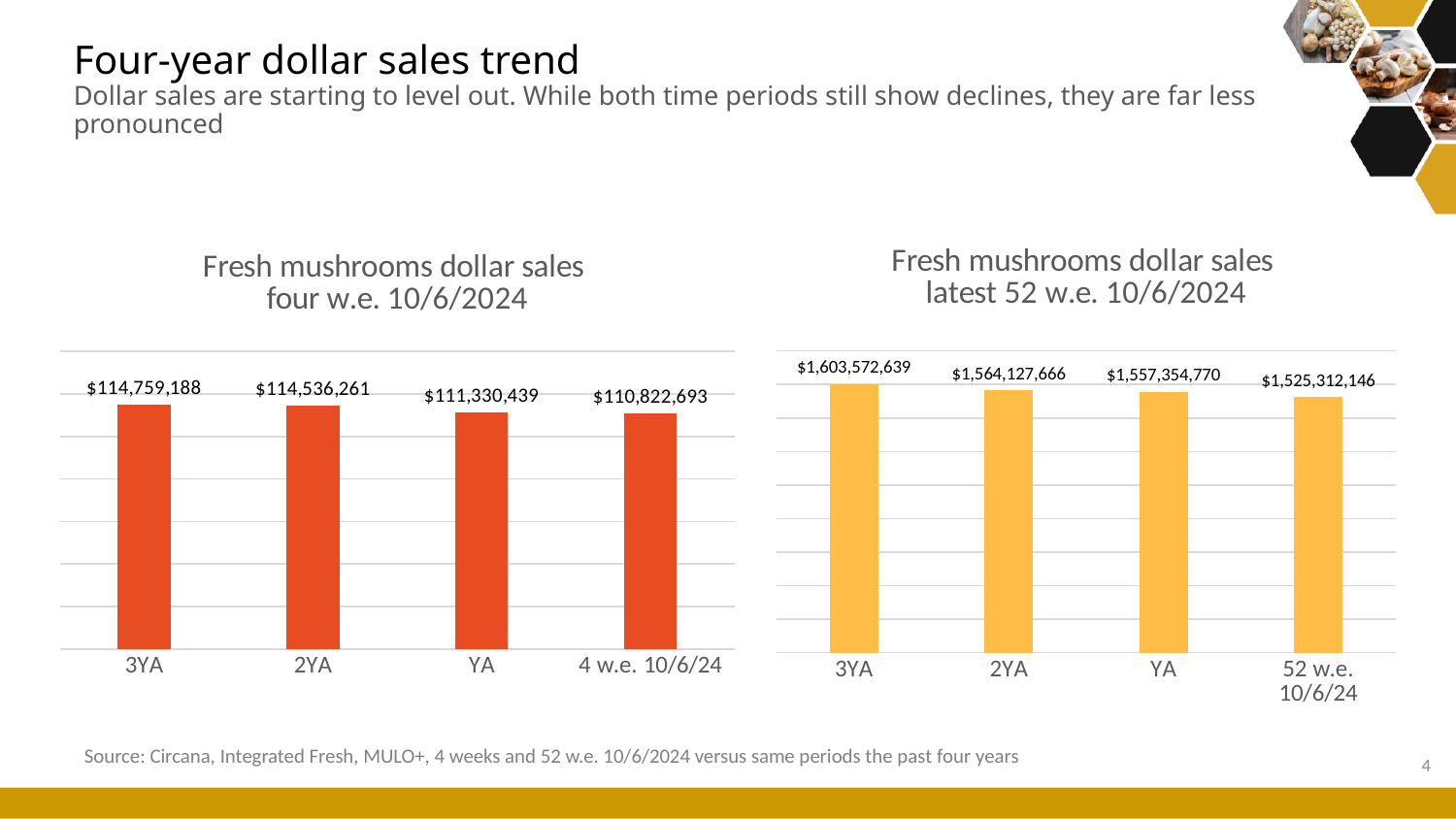
In the 'Fresh mushrooms dollar sales latest 52 w.e. 10/6/2024' chart, what is the difference between the 3YA value and the 52 w.e. 10/6/24 value? $78,260,493 How many categories are shown in the 'Fresh mushrooms dollar sales latest 52 w.e. 10/6/2024' chart? 4 In the 'Fresh mushrooms dollar sales latest 52 w.e. 10/6/2024' chart, what is the value for 52 w.e. 10/6/24? $1,525,312,146 In the 'Fresh mushrooms dollar sales four w.e. 10/6/2024' chart, which is larger, the value for 2YA or the value for YA? 2YA In the 'Fresh mushrooms dollar sales four w.e. 10/6/2024' chart, which category has the lowest value? 4 w.e. 10/6/24 What kind of chart is the 'Fresh mushrooms dollar sales four w.e. 10/6/2024' chart? Bar chart In the 'Fresh mushrooms dollar sales latest 52 w.e. 10/6/2024' chart, what is the value for 2YA? $1,564,127,666 In the 'Fresh mushrooms dollar sales four w.e. 10/6/2024' chart, what is the value for 3YA? $114,759,188 In the 'Fresh mushrooms dollar sales latest 52 w.e. 10/6/2024' chart, which category has the highest value? 3YA In the 'Fresh mushrooms dollar sales four w.e. 10/6/2024' chart, what is the value for 4 w.e. 10/6/24? $110,822,693 In the 'Fresh mushrooms dollar sales four w.e. 10/6/2024' chart, what is the difference between the 3YA value and the 4 w.e. 10/6/24 value? $3,936,495 In the 'Fresh mushrooms dollar sales latest 52 w.e. 10/6/2024' chart, do the values rise or fall from 3YA to 52 w.e. 10/6/24? Fall